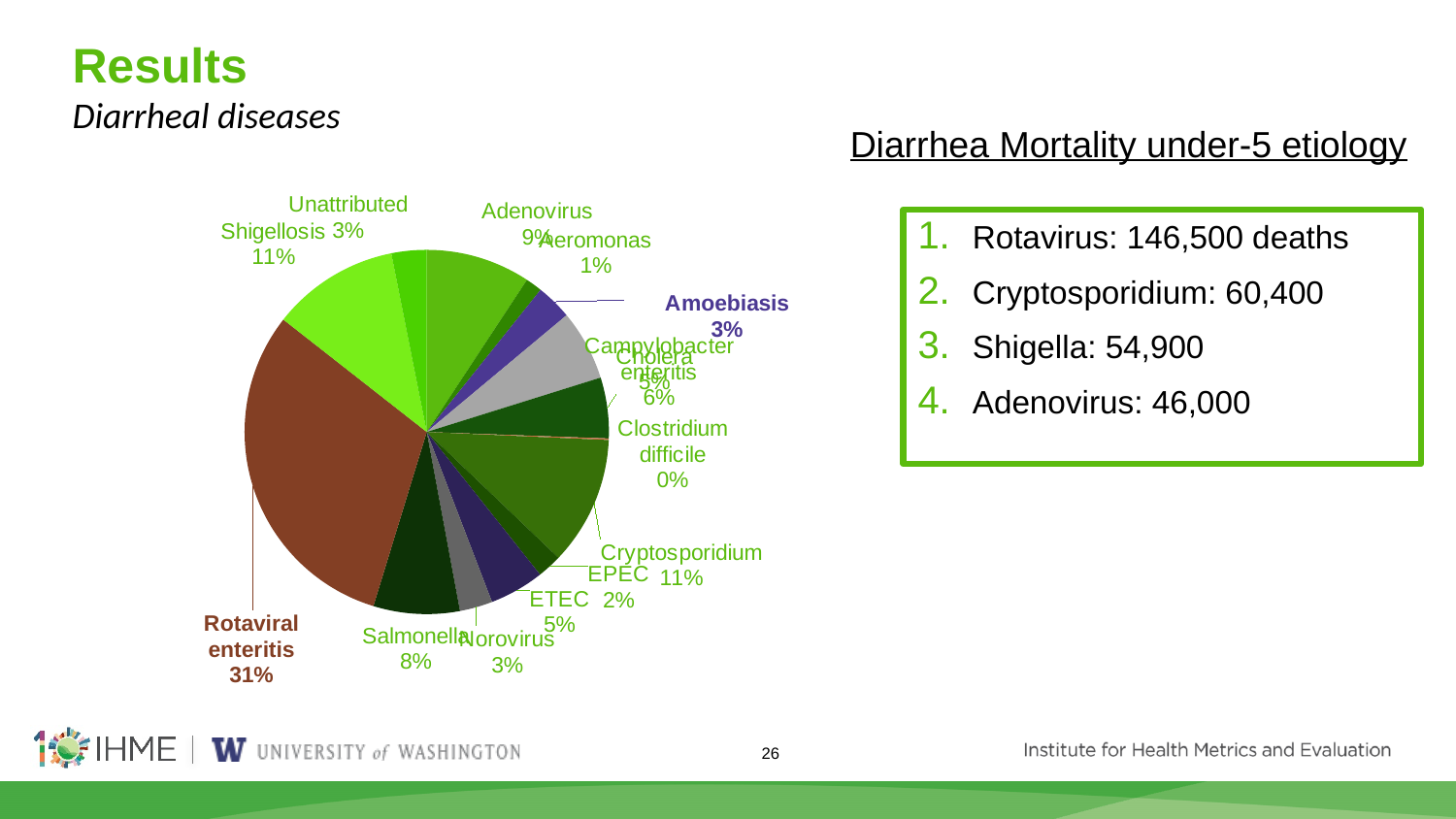
Which category has the smallest share of the pie? Clostridium difficile What kind of chart is shown on the slide? pie chart What percentage is shown for Salmonella? 8% What percentage is shown for Clostridium difficile? 0% What is the difference in percentage points between Rotaviral enteritis and Cryptosporidium? 20 percentage points What percentage is shown for Shigellosis? 11% What colour is the Rotaviral enteritis slice? brown What share of the pie does Adenovirus represent? 9% What percentage is shown for ETEC? 5% Which category has the largest slice of the pie? Rotaviral enteritis What percentage is shown for Rotaviral enteritis? 31% Which has a larger share, Salmonella or Norovirus? Salmonella